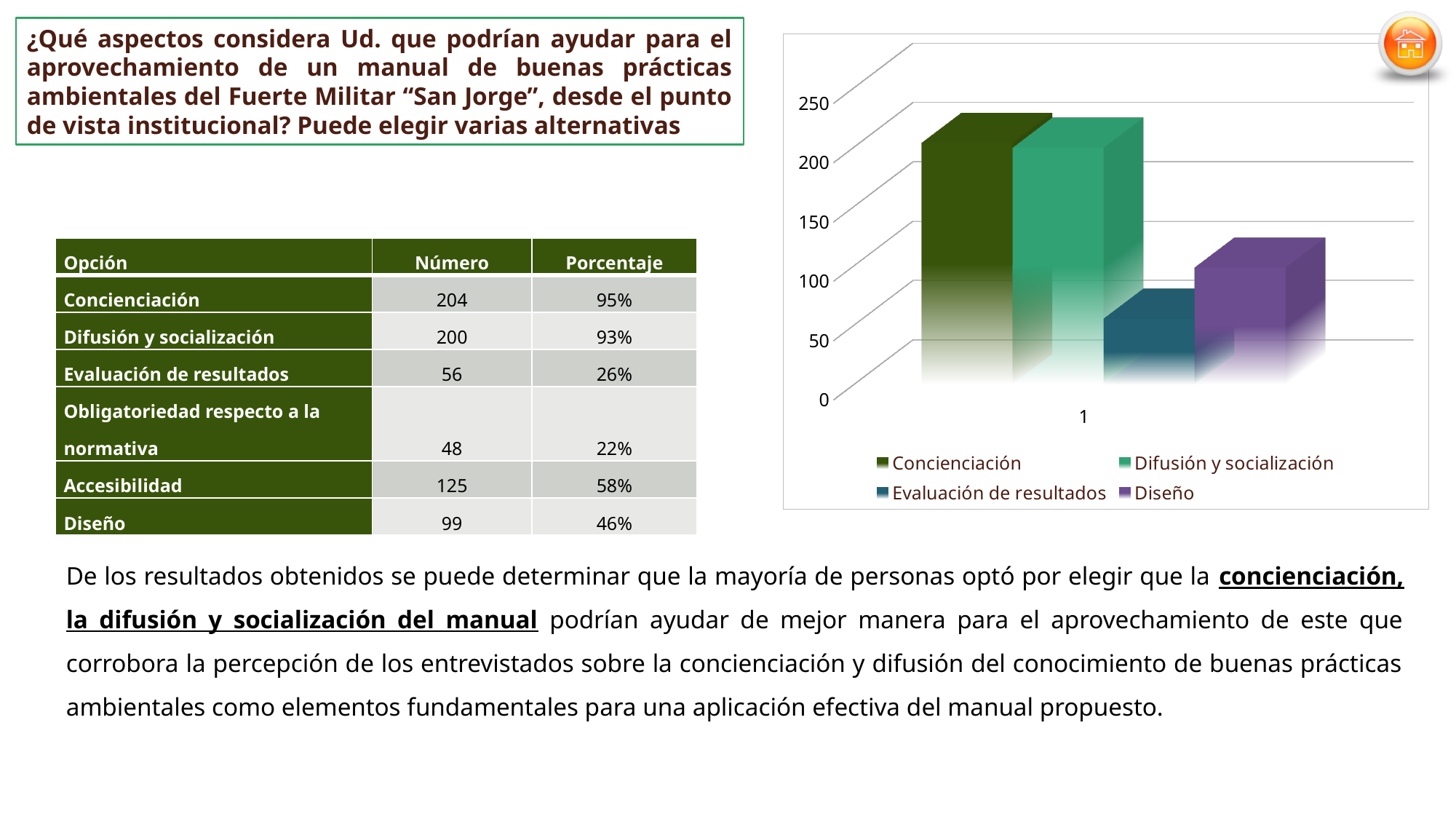
What colour is the Diseño series in the chart's legend? purple How many series does the chart's legend list? 4 What is the value plotted for Diseño, as given in the table on the slide? 99 Is the value for Diseño in the chart greater or less than 50? greater What kind of chart is shown on the right of the slide? bar chart What is the difference between the values for Concienciación (204) and Evaluación de resultados (56)? 148 Is the value for Concienciación in the chart greater or less than 150? greater Which series in the chart has the lowest value? Evaluación de resultados In the chart, which is larger: Diseño or Evaluación de resultados? Diseño Is the value for Evaluación de resultados in the chart greater or less than 100? less What is the value plotted for Concienciación, as given in the table on the slide? 204 In the chart, which is larger: Concienciación or Diseño? Concienciación